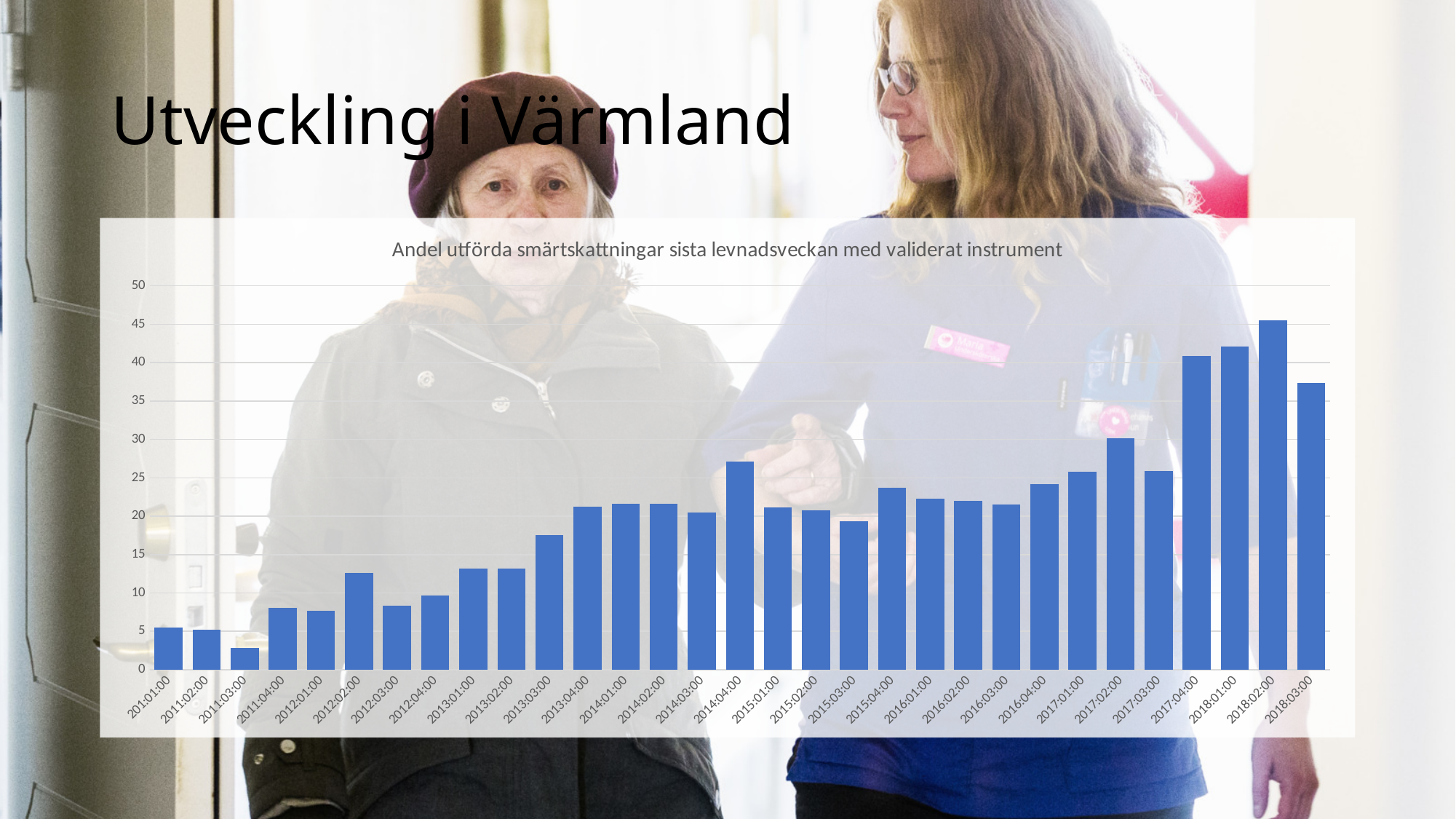
What kind of chart is shown on the slide? bar chart Which is larger, the value for 2017:02:00 or the value for 2017:03:00? 2017:02:00 Which category has the highest bar? 2018:02:00 How many bars are plotted in the chart? 31 What is the title of the chart? Andel utförda smärtskattningar sista levnadsveckan med validerat instrument Which category has the lowest bar? 2011:03:00 Is the value for 2014:04:00 greater or less than 25? greater Is the value for 2018:02:00 greater or less than 40? greater Which is larger, the value for 2018:02:00 or the value for 2018:03:00? 2018:02:00 Is the value for 2011:03:00 greater or less than 5? less Do the values generally rise or fall from 2011 to 2018 along the x axis? rise